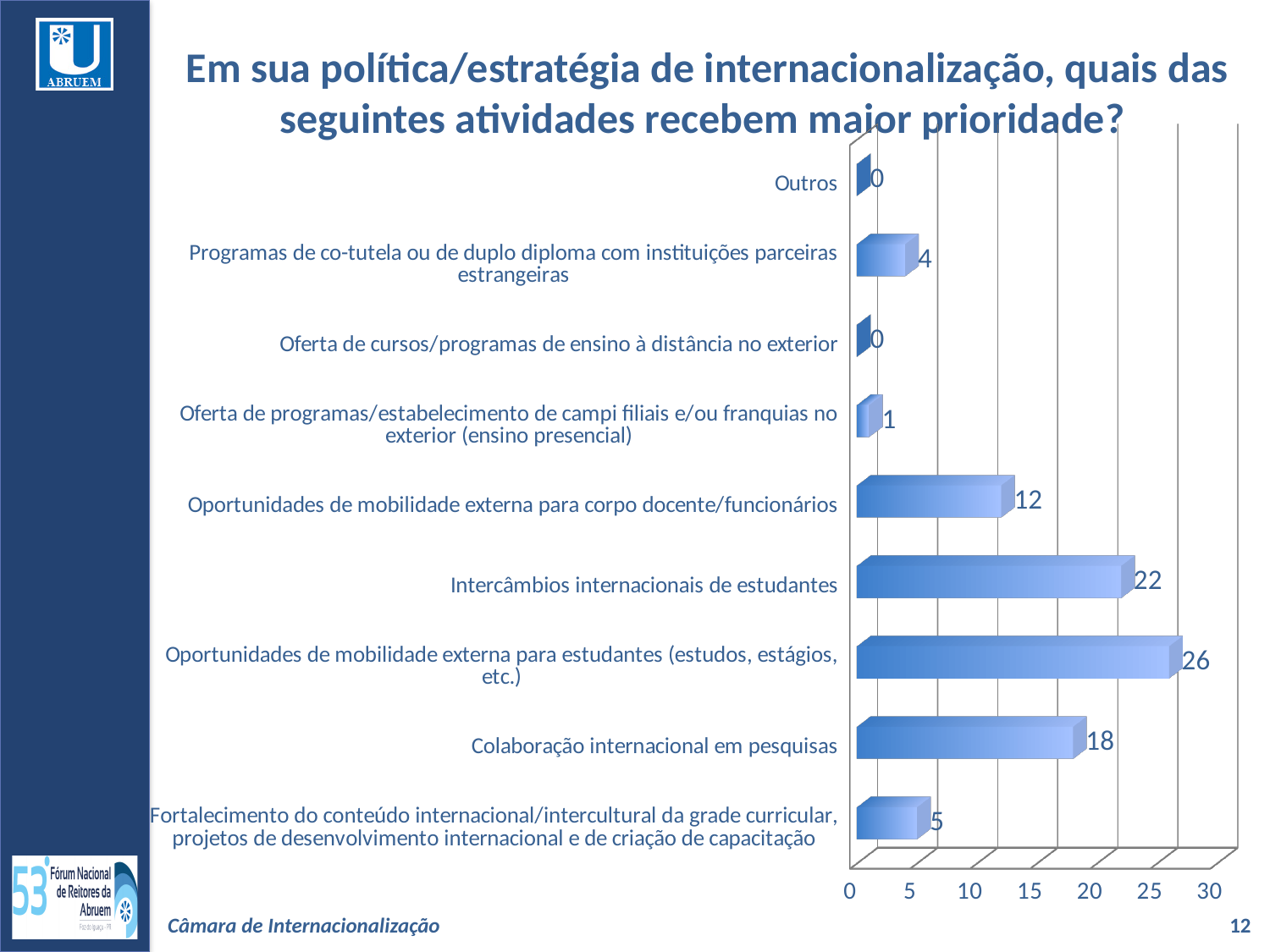
How many categories have a value of 0? 2 What is the value for "Programas de co-tutela ou de duplo diploma com instituições parceiras estrangeiras"? 4 How many categories are shown in the chart? 9 Which category has the highest value? Oportunidades de mobilidade externa para estudantes (estudos, estágios, etc.) What kind of chart is shown on the slide? bar chart What is the difference between the values for "Oportunidades de mobilidade externa para estudantes (estudos, estágios, etc.)" and "Intercâmbios internacionais de estudantes"? 4 What is the value for "Fortalecimento do conteúdo internacional/intercultural da grade curricular, projetos de desenvolvimento internacional e de criação de capacitação"? 5 What is the value for "Colaboração internacional em pesquisas"? 18 What is the value for "Oportunidades de mobilidade externa para corpo docente/funcionários"? 12 Which is larger: the value for "Colaboração internacional em pesquisas" or the value for "Oportunidades de mobilidade externa para corpo docente/funcionários"? Colaboração internacional em pesquisas Is the value for "Intercâmbios internacionais de estudantes" greater or less than 20? greater What is the value for "Intercâmbios internacionais de estudantes"? 22